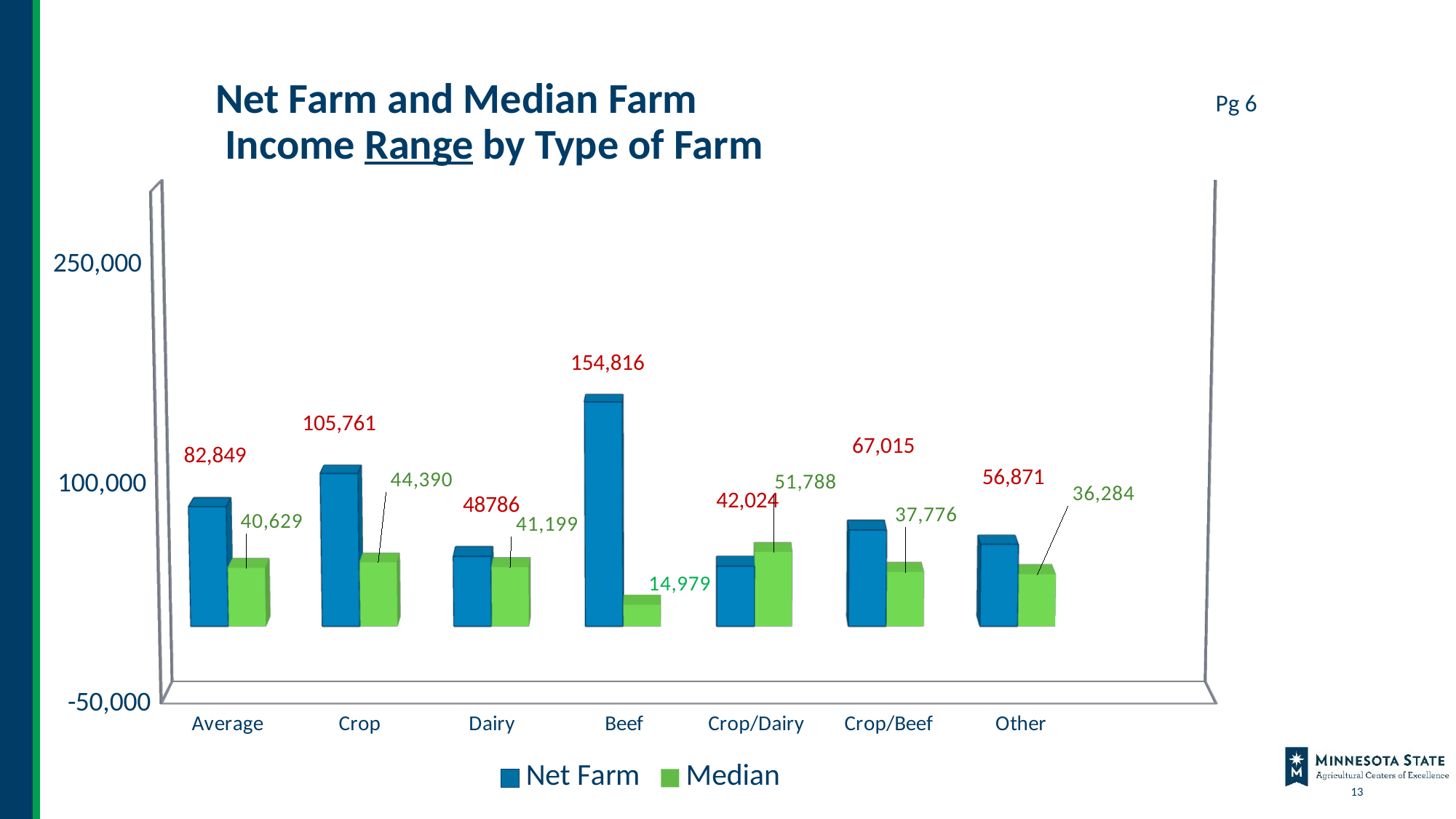
Which colour represents the Median series in the legend? Green Which type of farm has the highest Net Farm income? Beef Which type of farm has the lowest Net Farm income? Crop/Dairy Which type of farm has the lowest Median income? Beef What is the Median income value for Crop/Dairy? 51,788 What kind of chart is shown on the slide? Bar chart For Crop/Dairy, which is larger: the Net Farm value or the Median value? Median What is the Net Farm income value for Other? 56,871 What is the difference between the Net Farm and Median income values for Beef? 139,837 How many series does the legend list? 2 What is the Net Farm income value for Beef? 154,816 How many types of farm are shown on the x axis? 7